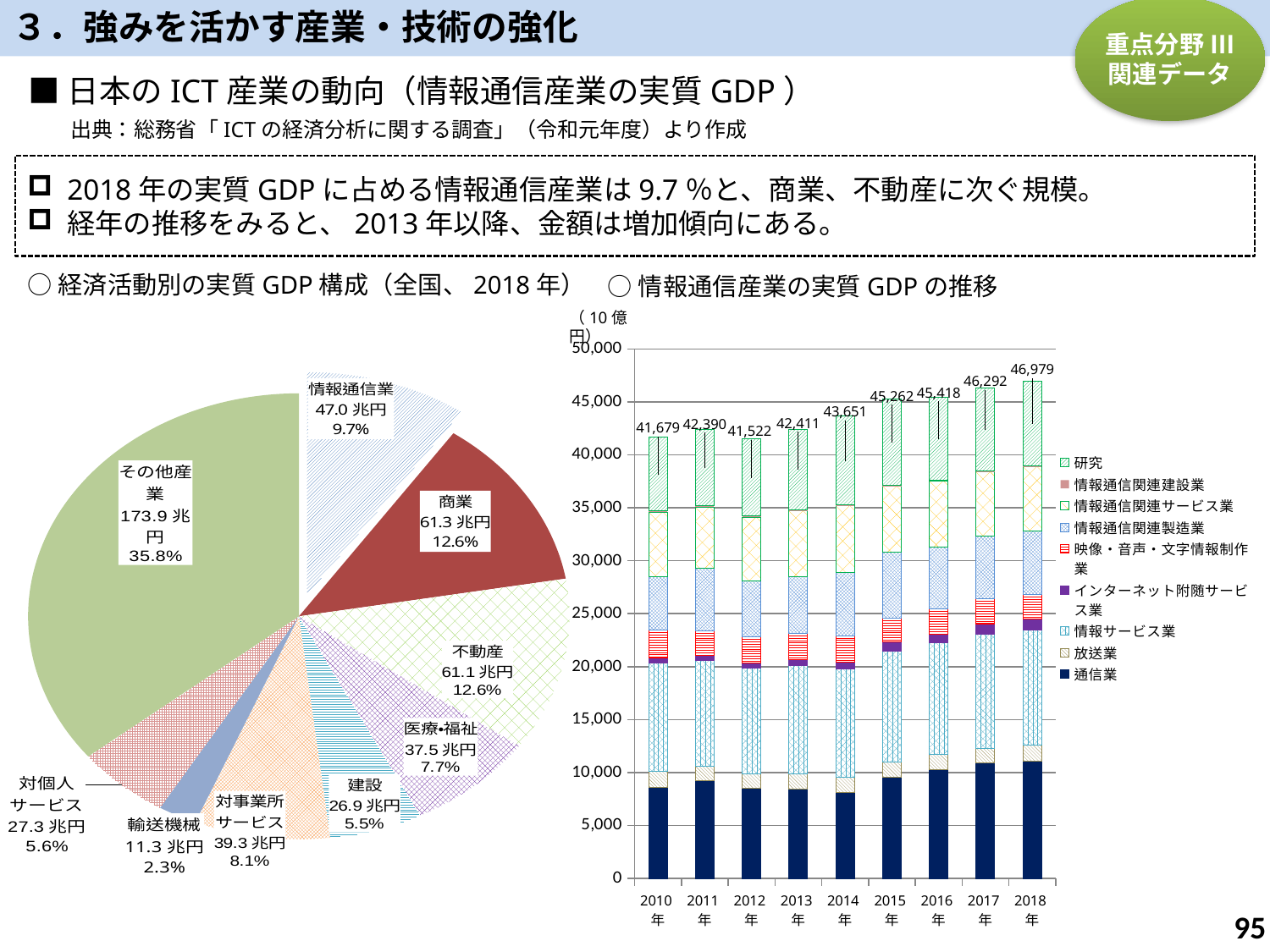
In the pie chart 経済活動別の実質GDP構成（全国、2018年）, what share of the pie does 商業 account for? 12.6% In the pie chart 経済活動別の実質GDP構成（全国、2018年）, what is the value shown for 情報通信業? 47.0兆円 In the pie chart 経済活動別の実質GDP構成（全国、2018年）, what is the difference in 兆円 between 商業 and 不動産? 0.2兆円 In the bar chart 情報通信産業の実質GDPの推移, what is the difference between the totals for 2018年 and 2010年? 5,300 In the pie chart 経済活動別の実質GDP構成（全国、2018年）, which category has the largest slice? その他産業 In the bar chart 情報通信産業の実質GDPの推移, which is larger, the total for 2011年 or 2013年? 2013年 In the pie chart 経済活動別の実質GDP構成（全国、2018年）, which category has the smallest slice? 輸送機械 In the bar chart 情報通信産業の実質GDPの推移, how many series does the legend list? 9 In the pie chart 経済活動別の実質GDP構成（全国、2018年）, how many categories are shown? 9 In the bar chart 情報通信産業の実質GDPの推移, what is the total value for 2018年? 46,979 In the bar chart 情報通信産業の実質GDPの推移, do the totals rise or fall from 2013年 to 2018年? rise In the bar chart 情報通信産業の実質GDPの推移, which year has the lowest total? 2012年